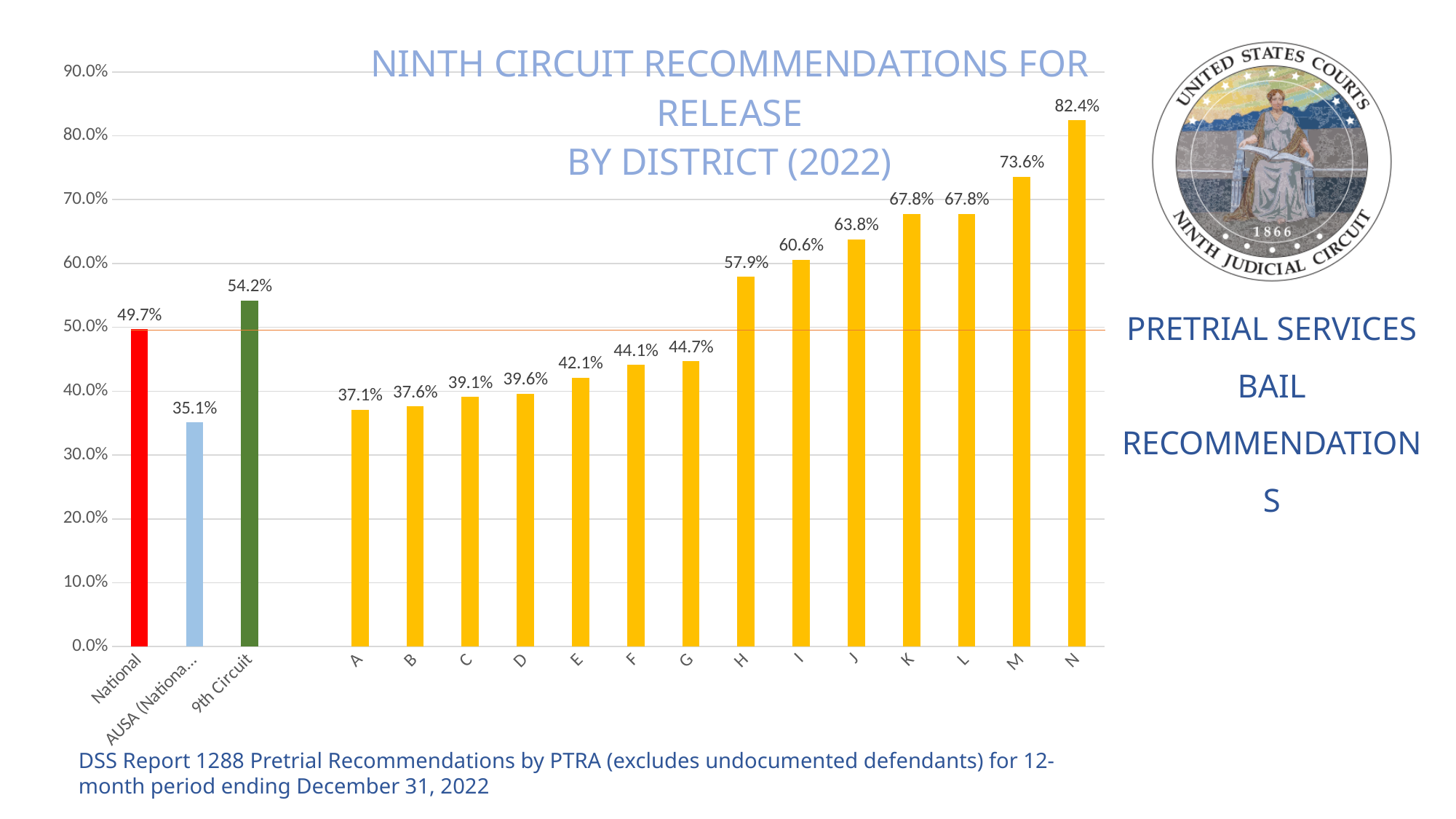
What is the value for district H? 57.9% What is the value for the 9th Circuit bar? 54.2% How many bars are plotted in the chart? 17 Which is larger, the value for district M or the value for district J? District M Do the values for districts A through N rise or fall from left to right? Rise Which district has the highest recommendation-for-release rate? N What type of chart is shown on the slide? Bar chart Among districts A through N, which has the lowest value? A What is the value for district N? 82.4% What is the value for the National bar? 49.7% What is the difference between district N and district A? 45.3% What is the difference between the 9th Circuit value and the National value? 4.5%